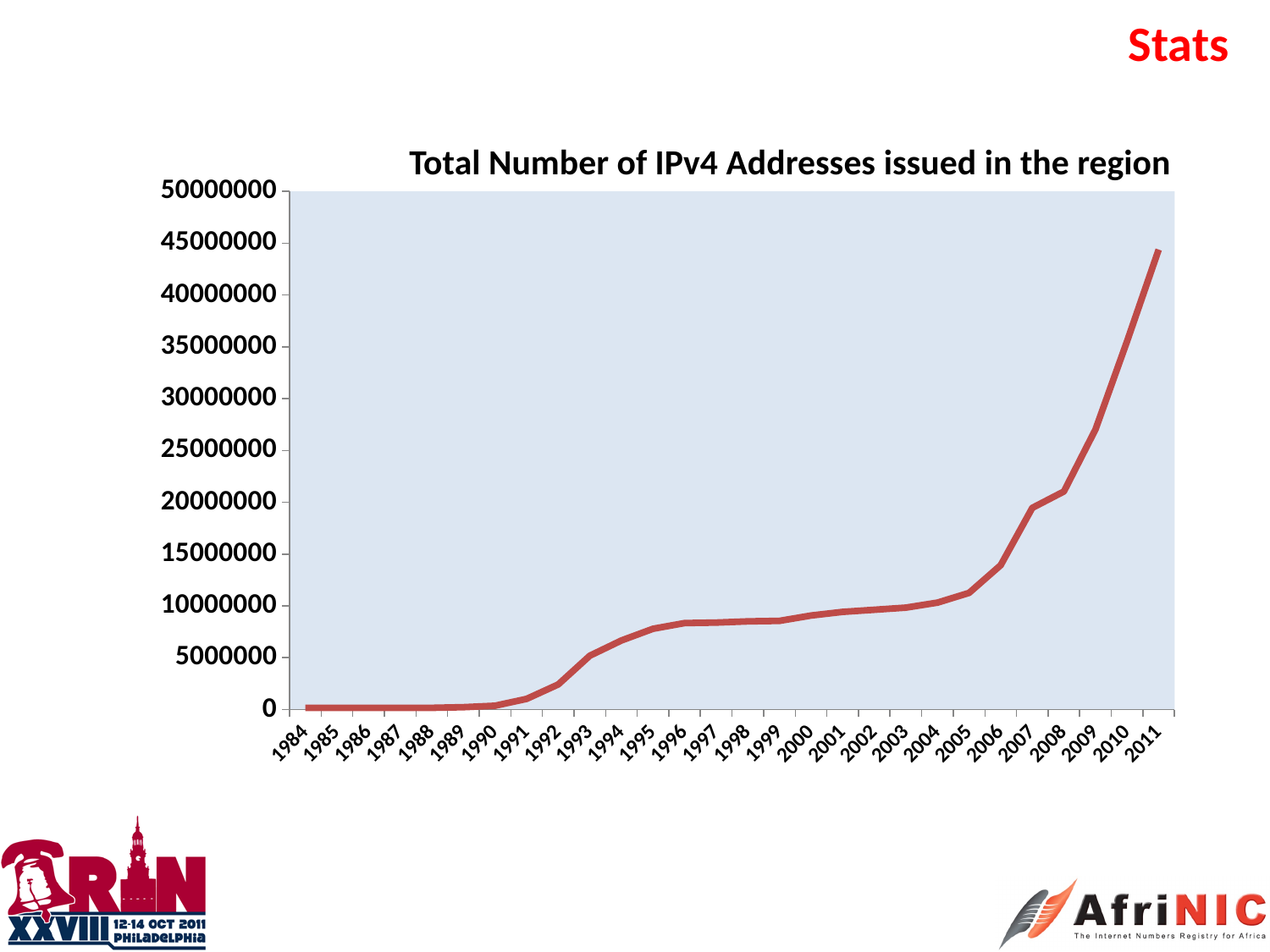
Is the value for 2000 greater or less than 10000000? less What colour is the plotted line? red Is the value for 2007 greater or less than 15000000? greater Which year has the highest value? 2011 How many years are plotted along the x axis? 28 What is the title of the chart? Total Number of IPv4 Addresses issued in the region Is the value for 2010 greater or less than 25000000? greater What kind of chart is shown on the slide? line chart Do the values generally rise or fall from 1984 to 2011? rise Which is larger, the value for 2007 or the value for 2000? 2007